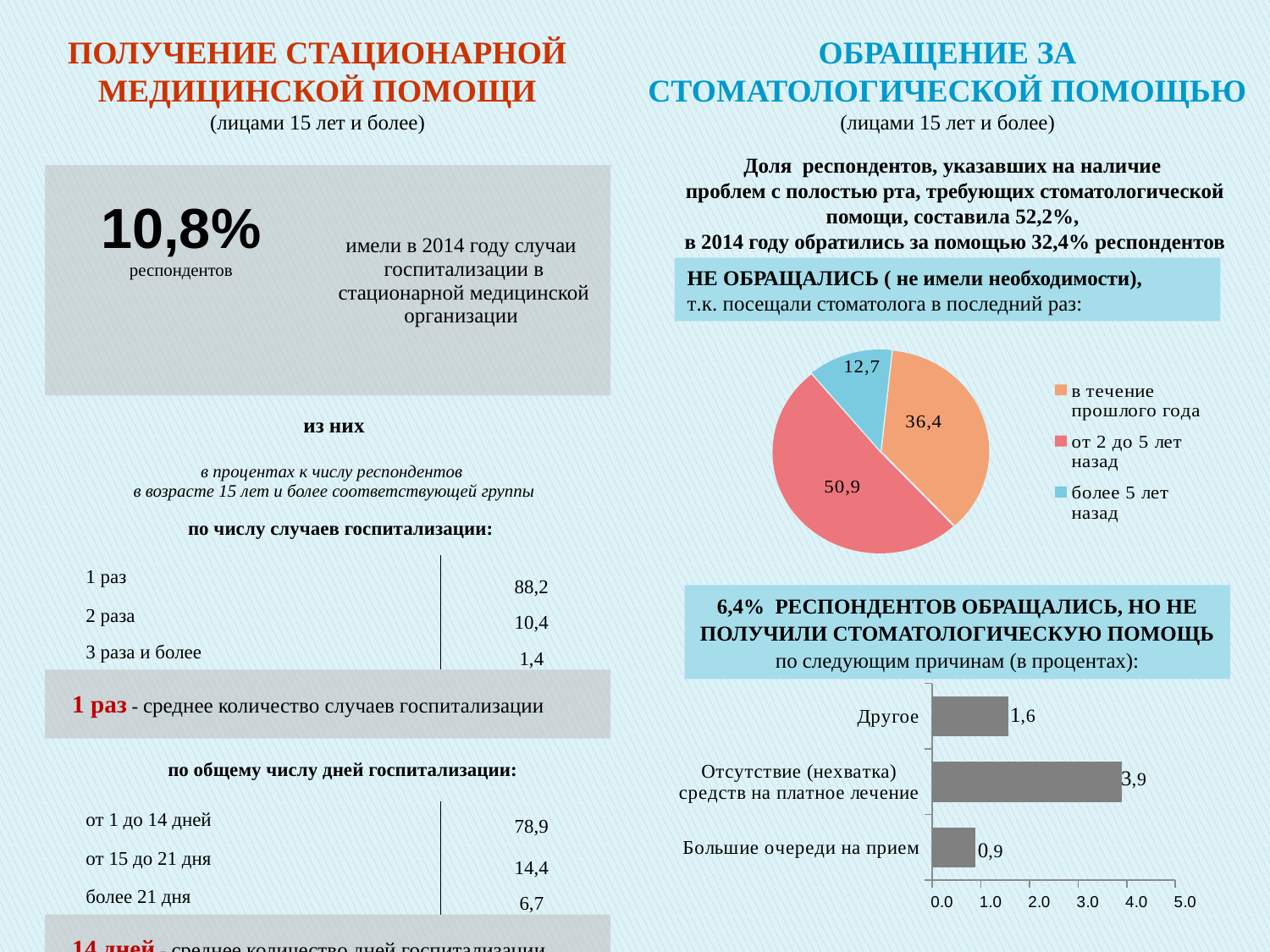
In the pie chart, what is the value for 'более 5 лет назад'? 12,7 In the bar chart at the bottom right, what is the value for 'Большие очереди на прием'? 0,9 In the bar chart at the bottom right, what is the value for 'Отсутствие (нехватка) средств на платное лечение'? 3,9 In the bar chart at the bottom right, what is the difference between 'Отсутствие (нехватка) средств на платное лечение' and 'Другое'? 2,3 In the bar chart at the bottom right, which reason has the highest value? Отсутствие (нехватка) средств на платное лечение In the pie chart, which category has the smallest slice? более 5 лет назад In the pie chart, which category has the largest slice? от 2 до 5 лет назад In the pie chart, what share of respondents last visited a dentist 'от 2 до 5 лет назад'? 50,9 In the bar chart at the bottom right, which is larger: 'Другое' or 'Большие очереди на прием'? Другое What type of chart is shown at the bottom right of the slide? bar chart How many categories does the pie chart legend list? 3 In the pie chart, what is the difference between 'от 2 до 5 лет назад' and 'в течение прошлого года'? 14,5